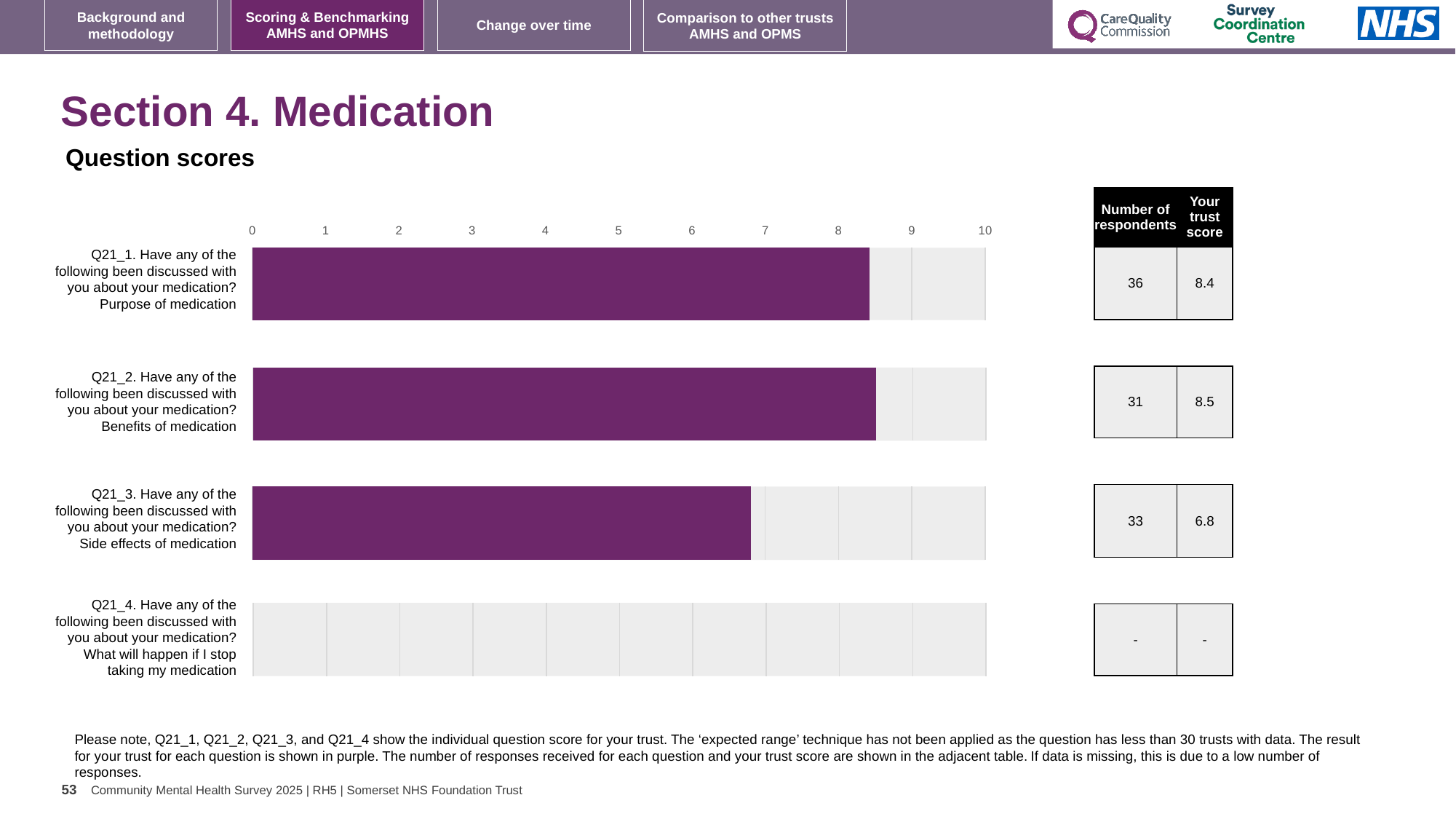
How many questions are listed on the chart? 4 What kind of chart is shown on the slide? bar chart How many respondents answered Q21_1 (Purpose of medication)? 36 What is the maximum value shown on the chart's axis? 10 What is the trust score for Q21_1 (Purpose of medication)? 8.4 Which question has the lowest plotted trust score? Q21_3. Side effects of medication What is the trust score for Q21_2 (Benefits of medication)? 8.5 What is the difference between the trust scores for Q21_2 (Benefits of medication) and Q21_3 (Side effects of medication)? 1.7 How many respondents answered Q21_3 (Side effects of medication)? 33 Is the trust score for Q21_3 (Side effects of medication) greater or less than 7? less What is the trust score for Q21_3 (Side effects of medication)? 6.8 Which question has the highest trust score? Q21_2. Benefits of medication